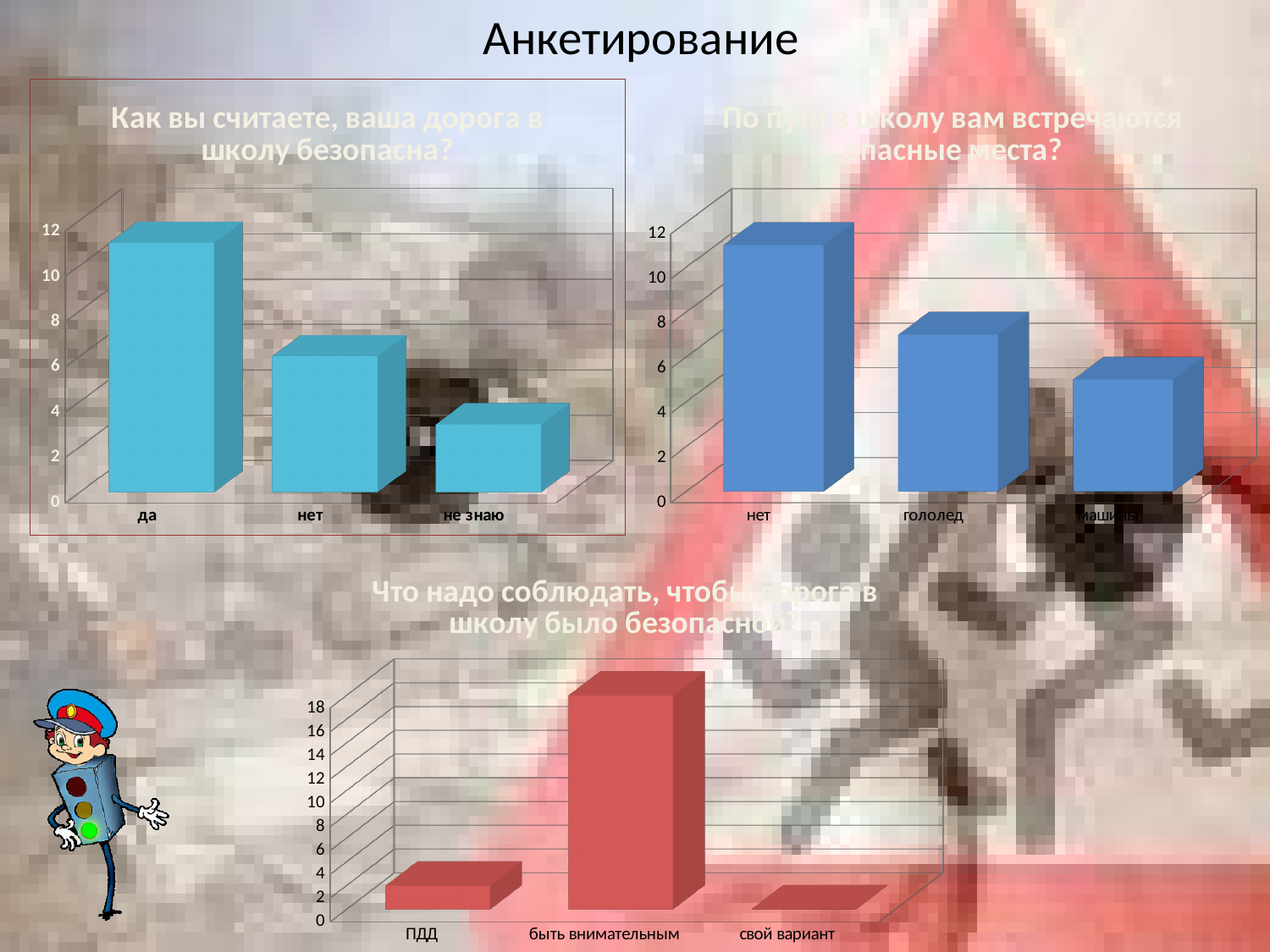
What kind of chart is the bottom chart ("Что надо соблюдать, чтобы дорога в школу было безопасной?")? bar chart In the bottom chart ("Что надо соблюдать, чтобы дорога в школу было безопасной?"), which category has the highest value? быть внимательным In the chart titled "Как вы считаете, ваша дорога в школу безопасна?", is the value for "да" greater or less than 10? greater In the top-right chart ("По пути в школу вам встречаются опасные места?"), is the value for "машины" greater or less than 6? less In the bottom chart ("Что надо соблюдать, чтобы дорога в школу было безопасной?"), is the value for "быть внимательным" greater or less than 16? greater In the chart titled "Как вы считаете, ваша дорога в школу безопасна?", which category has the lowest value? не знаю In the top-right chart ("По пути в школу вам встречаются опасные места?"), which category has the highest value? нет How many categories are shown in the chart titled "Как вы считаете, ваша дорога в школу безопасна?"? 3 In the top-right chart ("По пути в школу вам встречаются опасные места?"), do the values rise or fall from left to right? fall In the chart titled "Как вы считаете, ваша дорога в школу безопасна?", which category has the highest value? да In the top-right chart ("По пути в школу вам встречаются опасные места?"), which is larger, "гололед" or "машины"? гололед